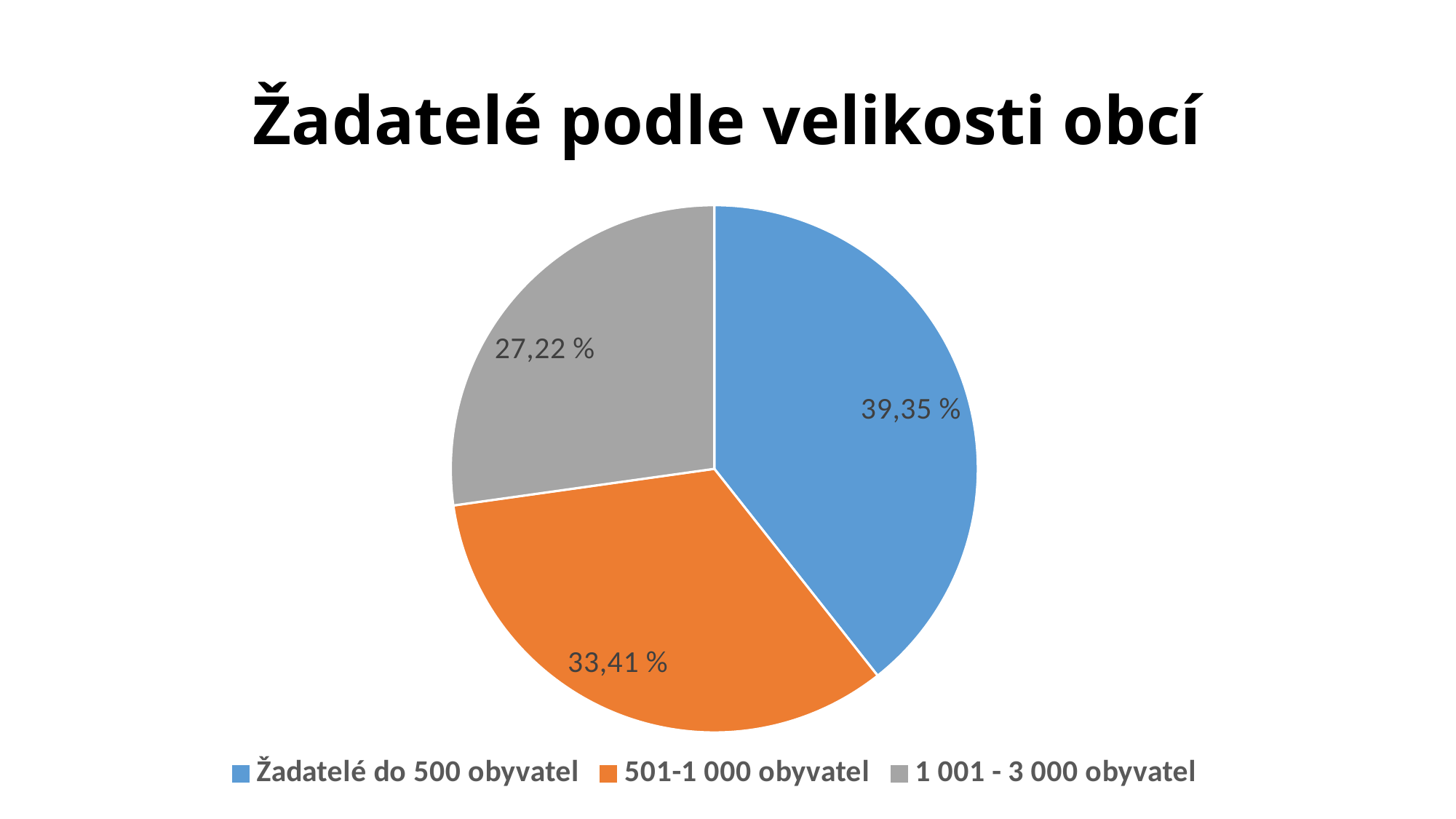
What share of the pie does the '1 001 - 3 000 obyvatel' slice represent? 27,22 % What kind of chart is shown on the slide? Pie chart Which is larger: the share for '501-1 000 obyvatel' or the share for '1 001 - 3 000 obyvatel'? 501-1 000 obyvatel What is the title of the chart? Žadatelé podle velikosti obcí What is the difference in percentage points between the 'Žadatelé do 500 obyvatel' slice and the '1 001 - 3 000 obyvatel' slice? 12,13 What share of the pie does the '501-1 000 obyvatel' slice represent? 33,41 % Which category has the largest share of the pie? Žadatelé do 500 obyvatel Which colour represents the '501-1 000 obyvatel' category in the legend? Orange Which category has the smallest share of the pie? 1 001 - 3 000 obyvatel What share of the pie does the 'Žadatelé do 500 obyvatel' slice represent? 39,35 % How many slices does the pie chart have? 3 What is the difference in percentage points between the '501-1 000 obyvatel' slice and the '1 001 - 3 000 obyvatel' slice? 6,19